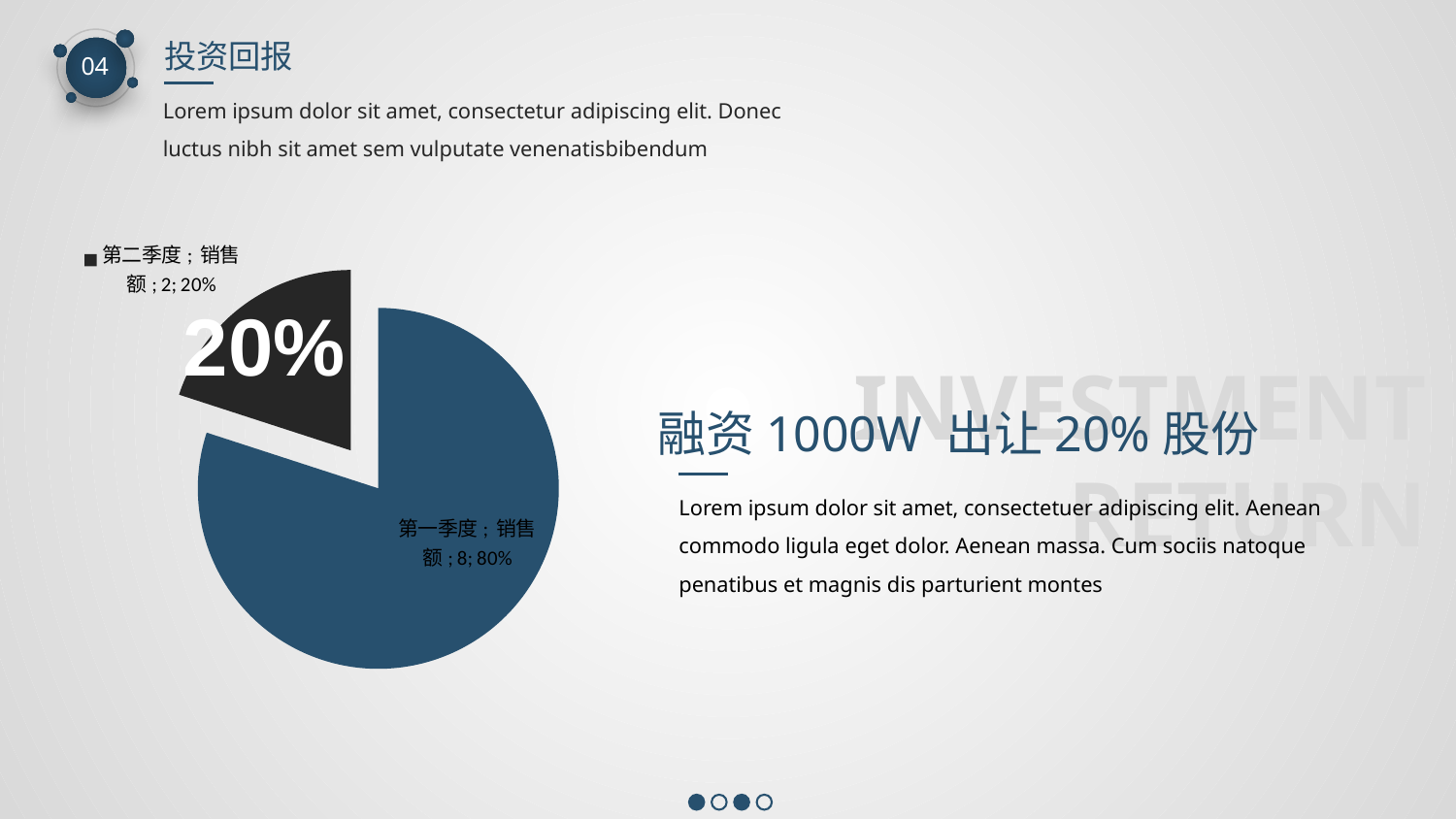
What kind of chart is shown on the slide? pie chart What is the value for 第二季度 in the pie chart? 2 What large percentage is printed over the dark slice of the pie chart? 20% Which slice of the pie chart is the largest? 第一季度 What is the difference between the values for 第一季度 and 第二季度? 6 Which slice of the pie chart is the smallest? 第二季度 What is the total of the two slice values in the pie chart? 10 What share of the pie does 第一季度 represent? 80% What is the value for 第一季度 in the pie chart? 8 What share of the pie does 第二季度 represent? 20% Which is larger, the value for 第一季度 or 第二季度? 第一季度 How many slices does the pie chart have? 2